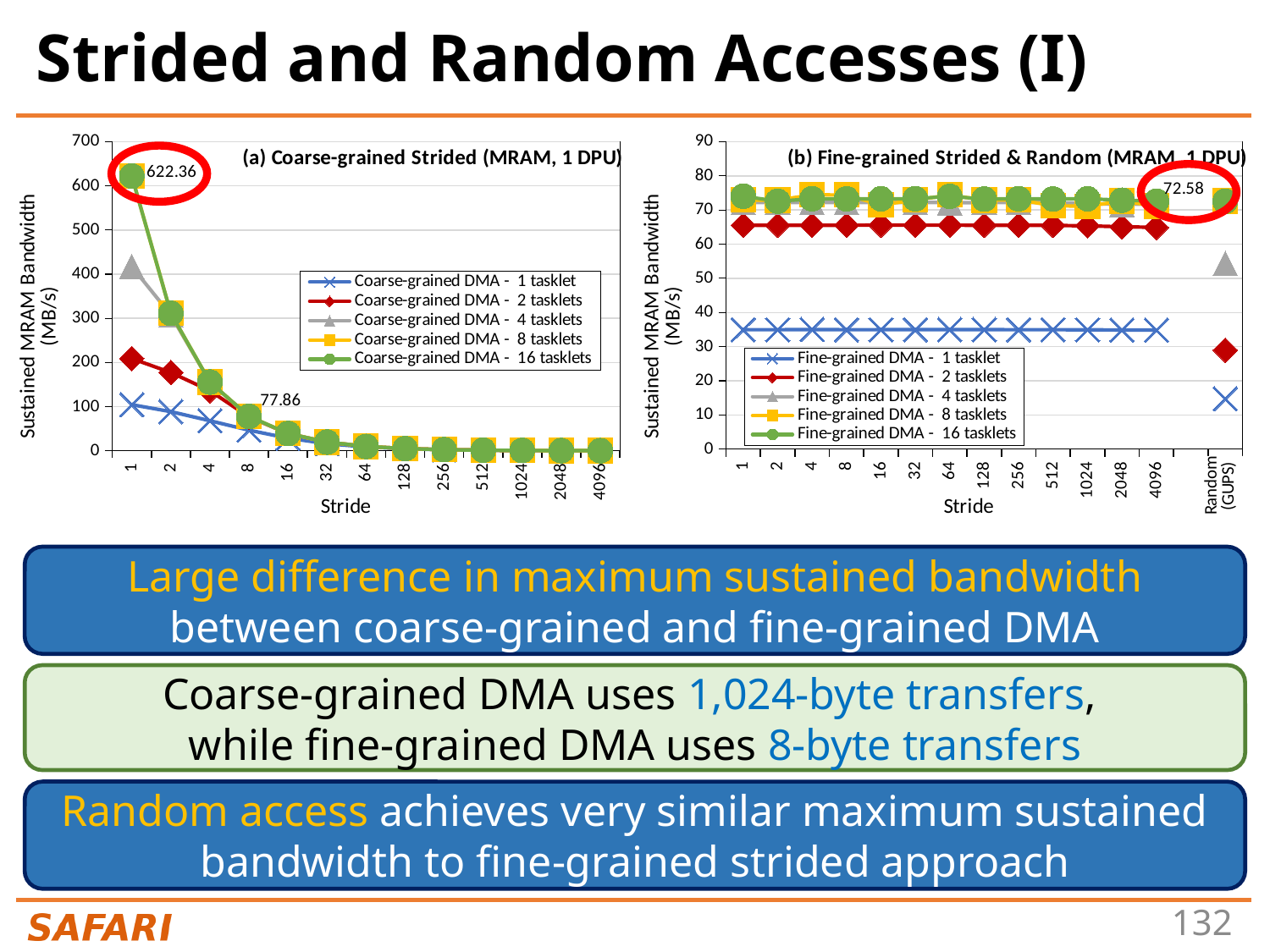
In chart (a) Coarse-grained Strided (MRAM, 1 DPU), how many series does the legend list? 5 In chart (a) Coarse-grained Strided (MRAM, 1 DPU), what is the labelled value at stride 1 that is circled in red? 622.36 In chart (a) Coarse-grained Strided (MRAM, 1 DPU), does the Coarse-grained DMA - 16 tasklets series rise or fall as the stride increases? fall In chart (b) Fine-grained Strided & Random (MRAM, 1 DPU), is the value for Fine-grained DMA - 1 tasklet at stride 1 greater or less than 40? less In chart (a) Coarse-grained Strided (MRAM, 1 DPU), is the value for Coarse-grained DMA - 1 tasklet at stride 1 greater or less than 200? less In chart (b) Fine-grained Strided & Random (MRAM, 1 DPU), at Random (GUPS), which is larger: Fine-grained DMA - 4 tasklets or Fine-grained DMA - 2 tasklets? Fine-grained DMA - 4 tasklets In chart (b) Fine-grained Strided & Random (MRAM, 1 DPU), how many series does the legend list? 5 In chart (b) Fine-grained Strided & Random (MRAM, 1 DPU), how many categories are shown on the x axis? 14 In chart (b) Fine-grained Strided & Random (MRAM, 1 DPU), what is the labelled value at Random (GUPS) that is circled in red? 72.58 What kind of chart is chart (a) Coarse-grained Strided (MRAM, 1 DPU)? line chart What is the y-axis label of chart (a) Coarse-grained Strided (MRAM, 1 DPU)? Sustained MRAM Bandwidth (MB/s) In chart (a) Coarse-grained Strided (MRAM, 1 DPU), how many stride values are shown on the x axis? 13